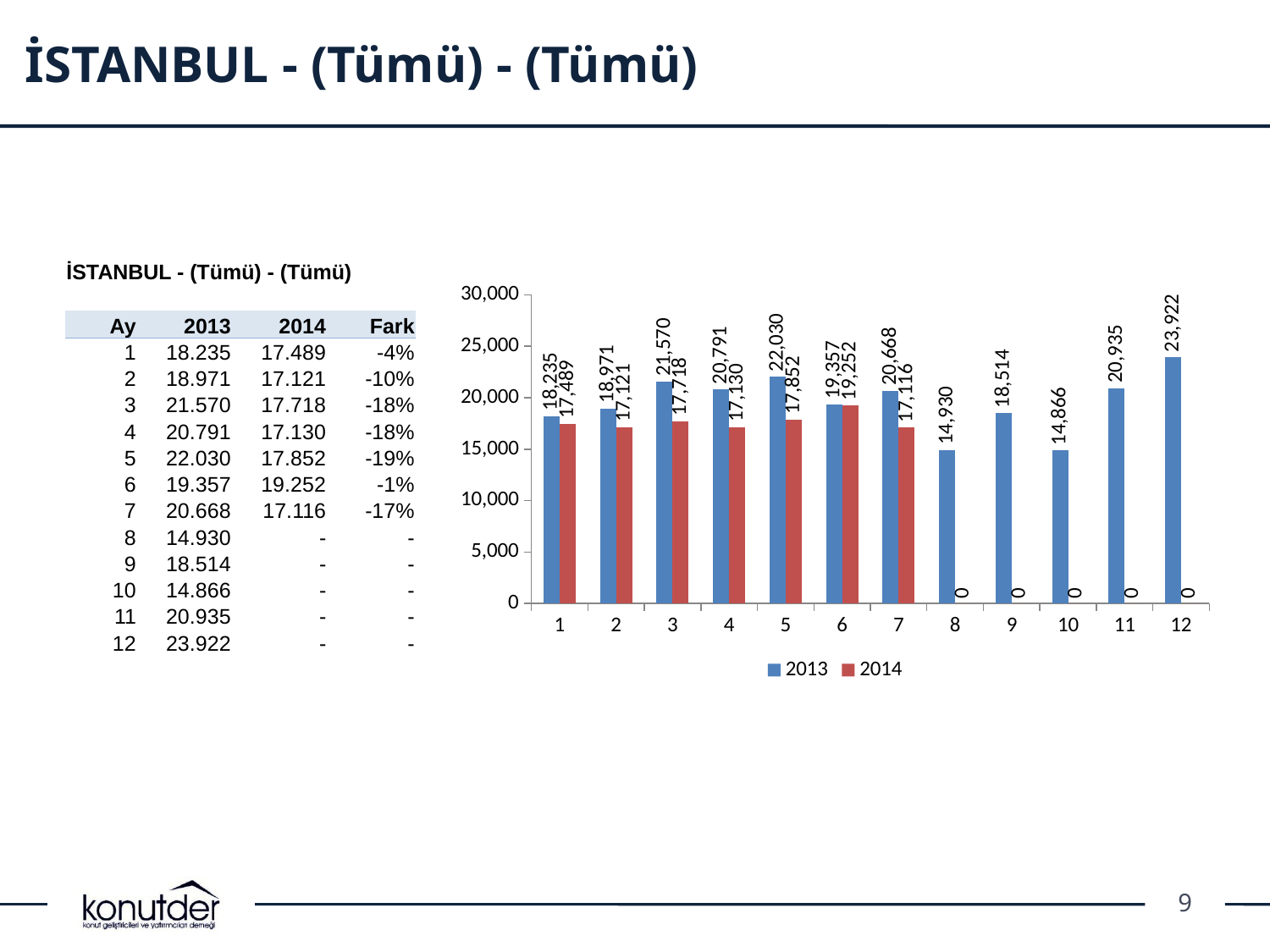
How many series does the legend list? 2 What kind of chart is shown? bar chart Is the 2013 value for month 8 greater or less than 15,000? less What is the difference between the 2013 and 2014 values for month 1? 746 What is the difference between the 2013 and 2014 values for month 3? 3,852 What is the 2014 value shown for month 8? 0 What is the 2014 value for month 6? 19,252 Which month has the lowest 2013 value? 10 Which is larger, the 2013 value for month 5 or the 2013 value for month 12? month 12 What is the 2013 value for month 5? 22,030 Which month has the highest 2013 value? 12 How many months are shown on the x axis? 12